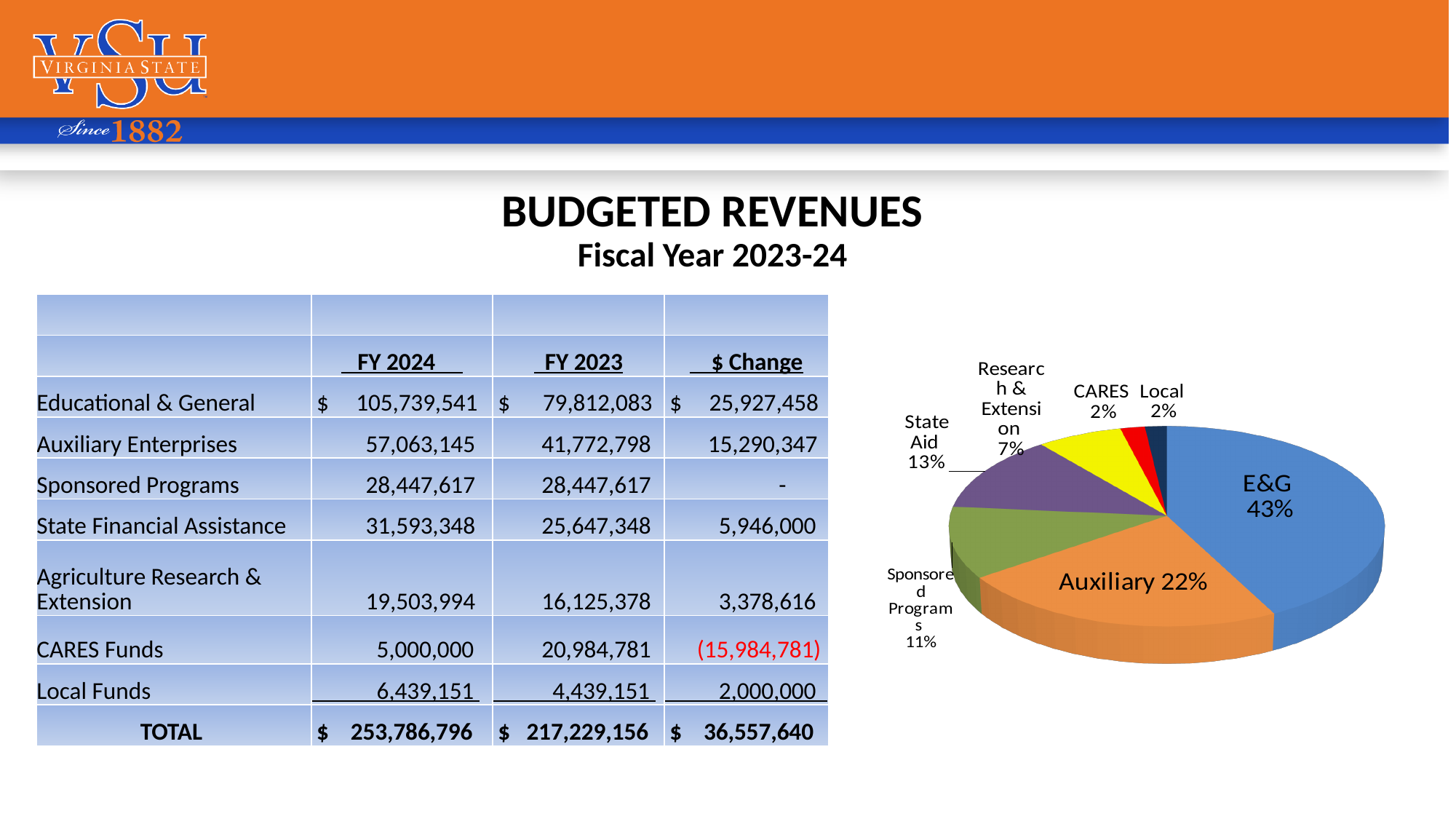
In the pie chart, what share does E&G have? 43% Which is larger in the pie chart, State Aid or Sponsored Programs? State Aid What is the difference in percentage points between the E&G and Auxiliary slices? 21 In the pie chart, what share does State Aid have? 13% In the pie chart, what share does CARES have? 2% Which slice of the pie chart is the largest? E&G How many slices does the pie chart have? 7 What kind of chart is shown on the slide? pie chart What colour is the E&G slice in the pie chart? blue